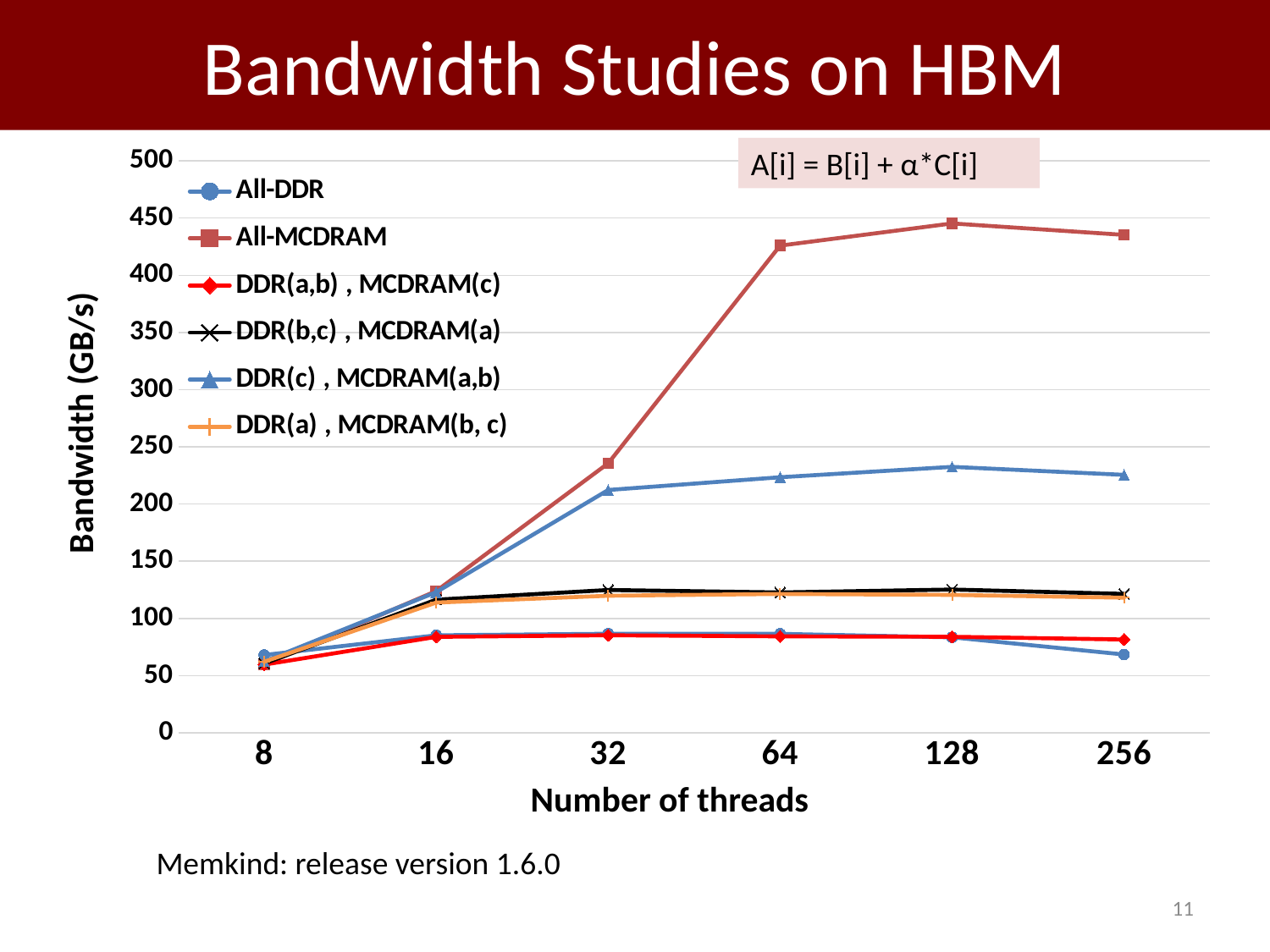
What is the label of the x axis? Number of threads Which series has the highest bandwidth at 256 threads? All-MCDRAM How many series does the legend list? 6 How many thread counts are plotted along the x axis? 6 Is the bandwidth for DDR(c) , MCDRAM(a,b) at 32 threads greater or less than 200? greater What kind of chart is shown on the slide? line chart Which series has the lowest bandwidth at 256 threads? All-DDR What is the label of the y axis? Bandwidth (GB/s) Is the bandwidth for All-DDR at 256 threads greater or less than 100? less Does the bandwidth for All-MCDRAM rise or fall from 8 threads to 128 threads? rise At 128 threads, which has the higher bandwidth: DDR(c) , MCDRAM(a,b) or DDR(b,c) , MCDRAM(a)? DDR(c) , MCDRAM(a,b) Is the bandwidth for All-MCDRAM at 64 threads greater or less than 400? greater